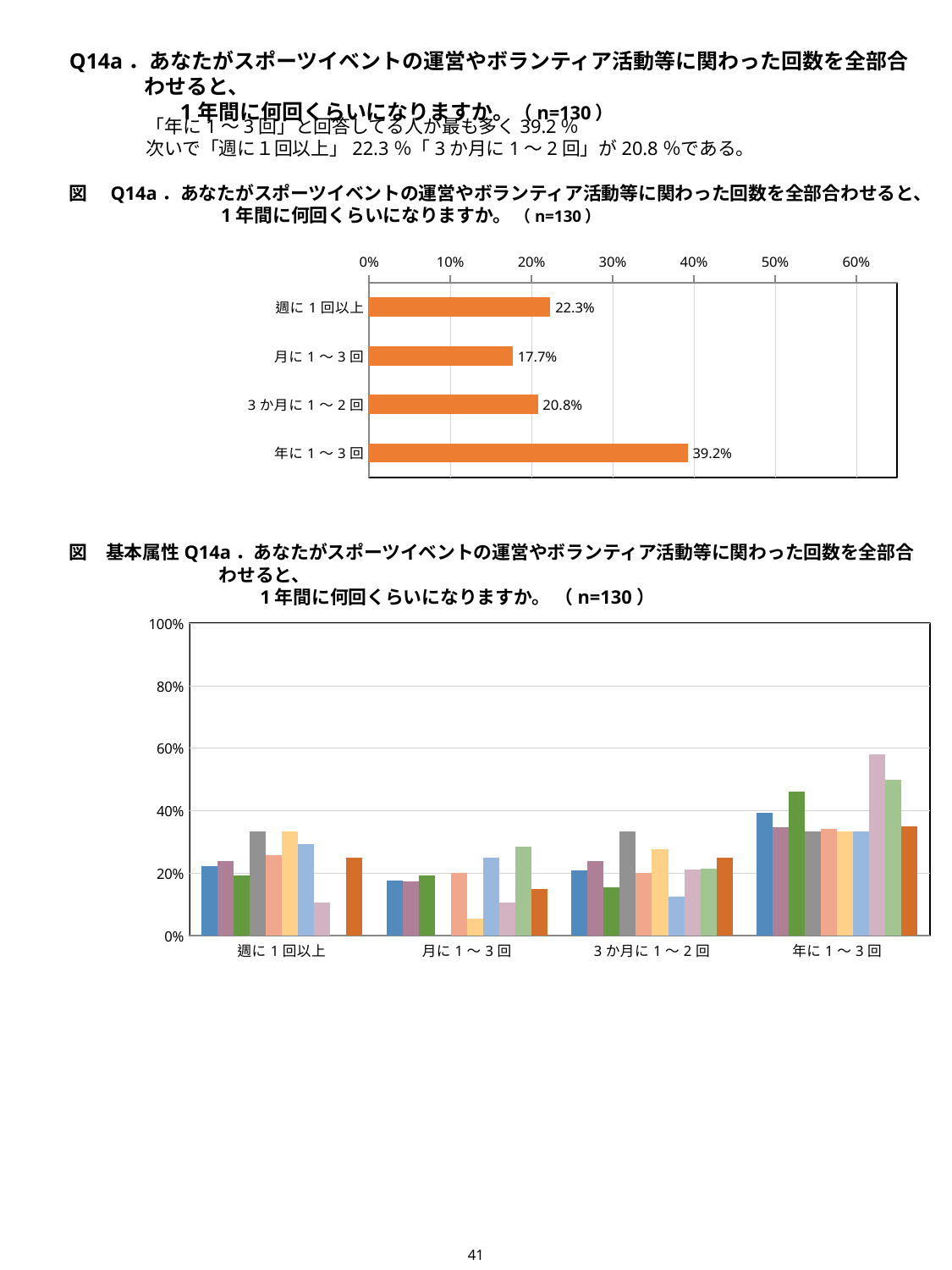
What kind of chart is the top chart? Bar chart In the top chart, which category has the highest value? 年に１～３回 In the top chart, what is the value for 年に１～３回? 39.2% In the top chart, which is larger: the value for 週に１回以上 or the value for ３か月に１～２回? 週に１回以上 In the bottom chart, is the tallest bar in the 月に１～３回 group greater or less than 40%? less In the top chart, how many categories are shown? 4 In the bottom chart, how many categories are shown on the x axis? 4 In the top chart, what is the value for ３か月に１～２回? 20.8% In the top chart, what is the difference between the values for 年に１～３回 and 週に１回以上? 16.9% In the top chart, what is the value for 月に１～３回? 17.7% In the bottom chart, is the tallest bar in the 年に１～３回 group greater or less than 50%? greater In the top chart, which category has the lowest value? 月に１～３回